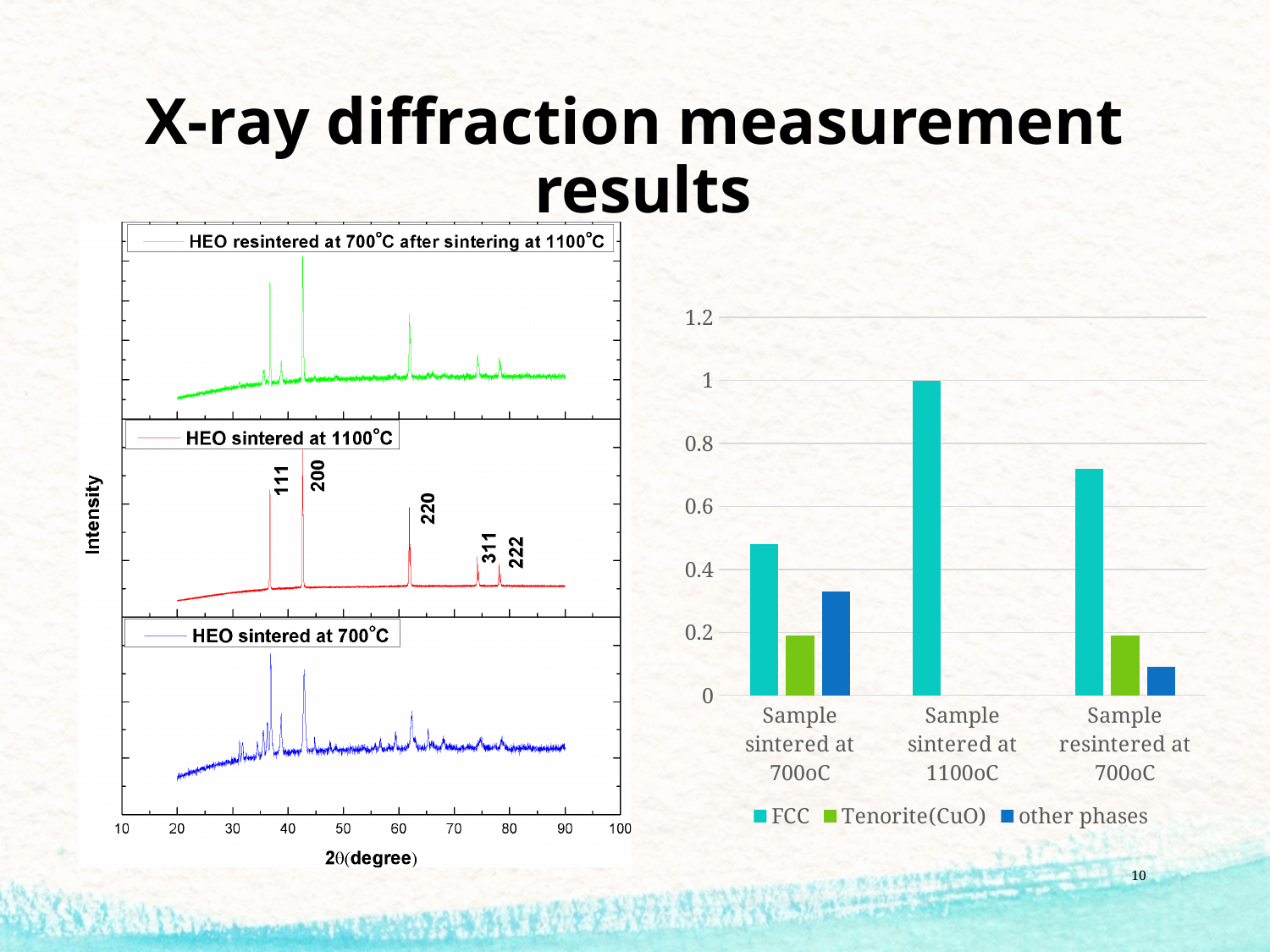
On the bar chart on the right, which category has the highest FCC value? Sample sintered at 1100oC On the bar chart on the right, what is the value of FCC for the sample sintered at 1100oC? 1 On the bar chart on the right, is the other phases value for the sample sintered at 700oC greater or less than 0.2? greater On the XRD plot on the left, what is the label of the x axis? 2θ(degree) On the bar chart on the right, which is larger: the FCC value for the sample sintered at 700oC or the FCC value for the sample resintered at 700oC? Sample resintered at 700oC On the bar chart on the right, which bar is the lowest of all? other phases for Sample resintered at 700oC On the bar chart on the right, is the FCC value for the sample sintered at 700oC greater or less than 0.4? greater On the bar chart on the right, is the other phases value for the sample resintered at 700oC greater or less than 0.2? less On the bar chart on the right, how many series does the legend list? 3 What kind of chart is shown on the right side of the slide? bar chart On the bar chart on the right, how many sample categories are shown on the x axis? 3